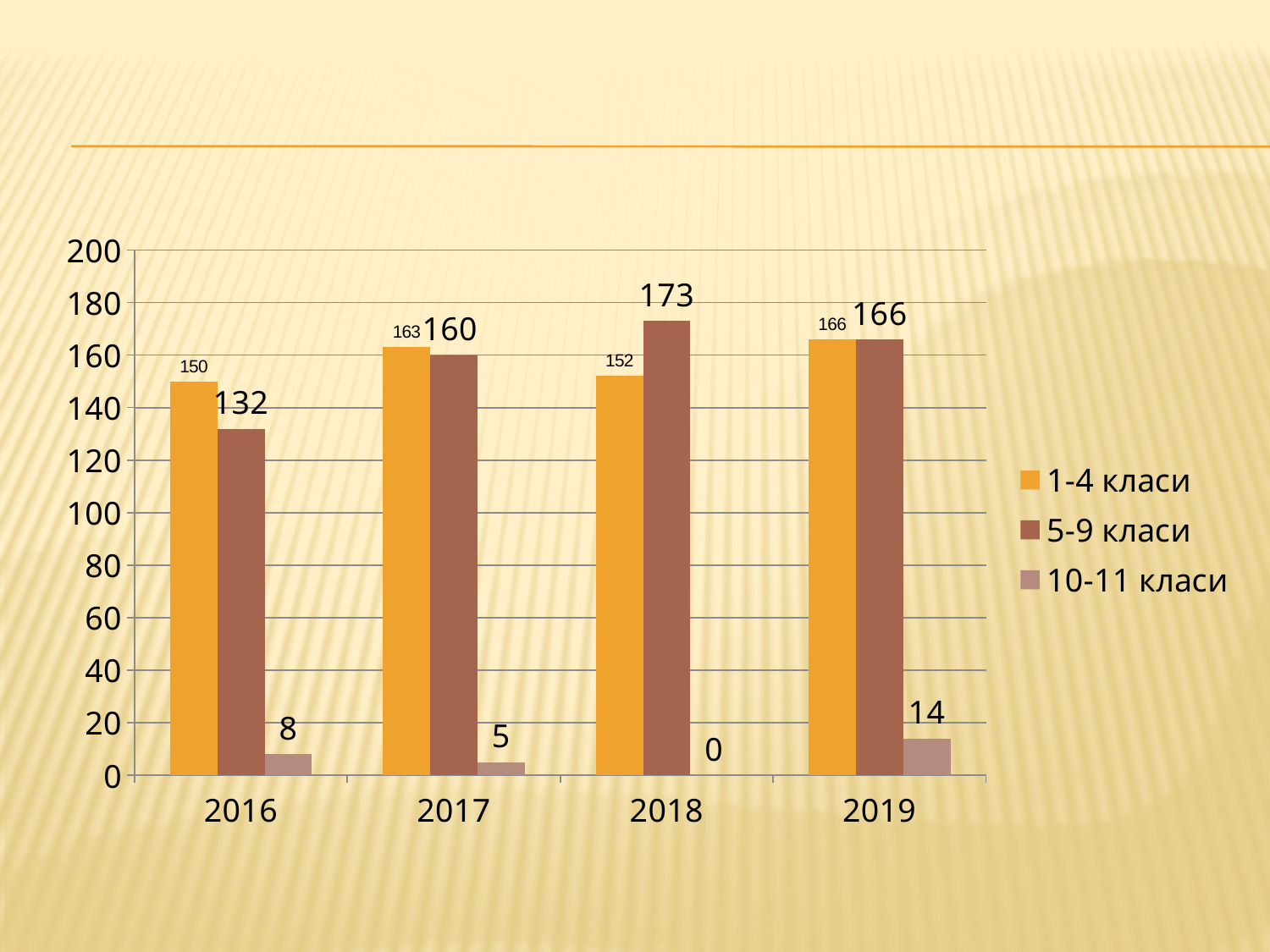
In which year is the value for 5-9 класи the highest? 2018 Which is larger in 2018: the value for 1-4 класи or for 5-9 класи? 5-9 класи What is the value for 5-9 класи in 2018? 173 What is the difference between the 1-4 класи and 5-9 класи values in 2016? 18 How many series does the legend list? 3 What is the total of the three series values in 2019? 346 In which year is the value for 1-4 класи the lowest? 2016 What is the value for 10-11 класи in 2018? 0 What is the value for 1-4 класи in 2016? 150 How many years are shown on the x axis? 4 What kind of chart is shown on the slide? Bar chart What is the value for 10-11 класи in 2019? 14